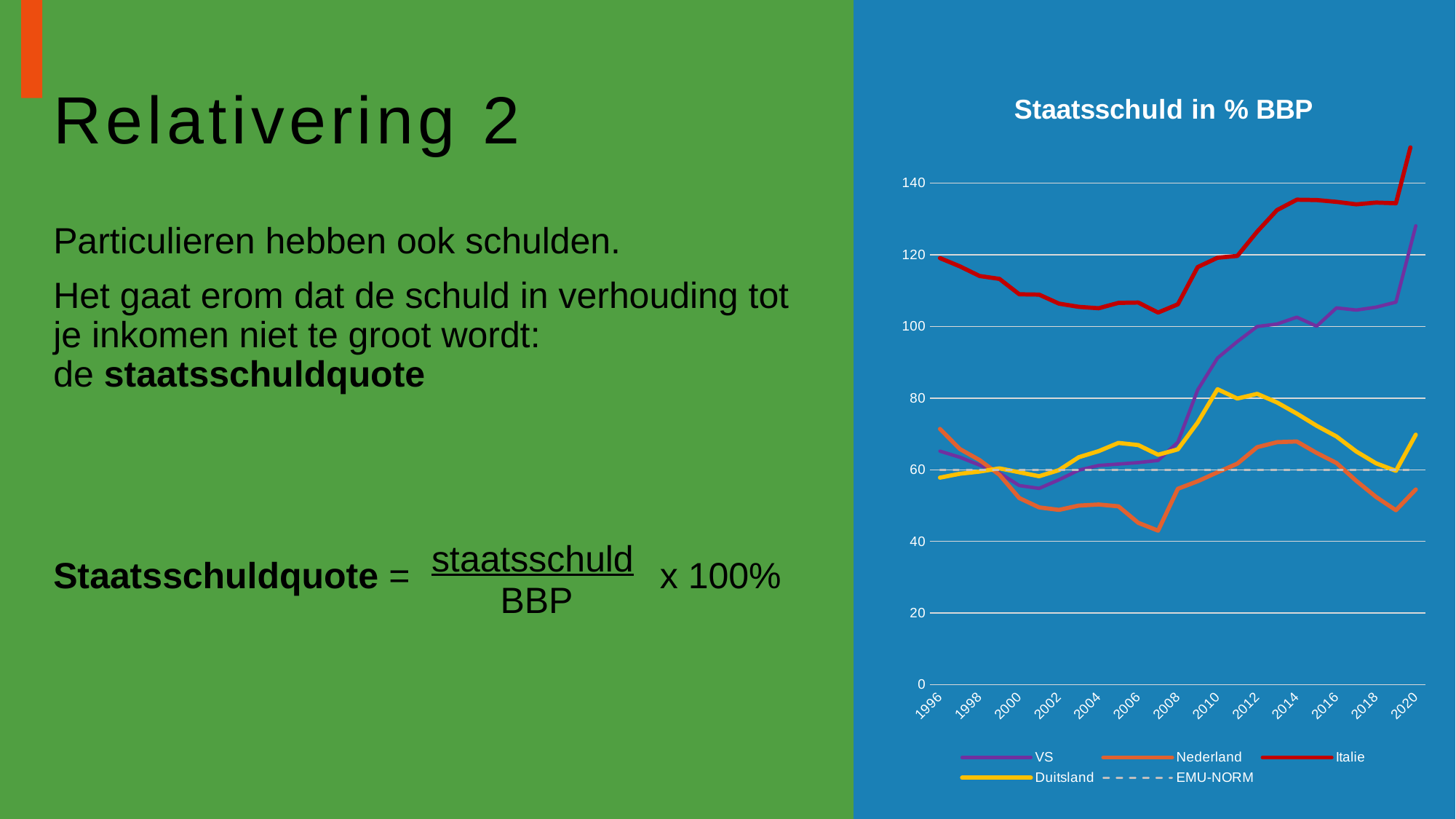
Which series has the highest value in 2020? Italie Which series has the lowest value in 2020? Nederland Is the value for Italie in 2020 greater or less than 140? greater How many series does the chart legend list? 5 What kind of chart is shown on the slide? line chart What is the title of the chart? Staatsschuld in % BBP Which series has the lowest value in 2008? Nederland Does the value for Italie rise or fall between 2008 and 2020? rise Is the value for Nederland in 2018 greater or less than 60? less Is the value for VS in 2020 greater or less than 120? greater In 2020, which is larger: the value for VS or the value for Duitsland? VS